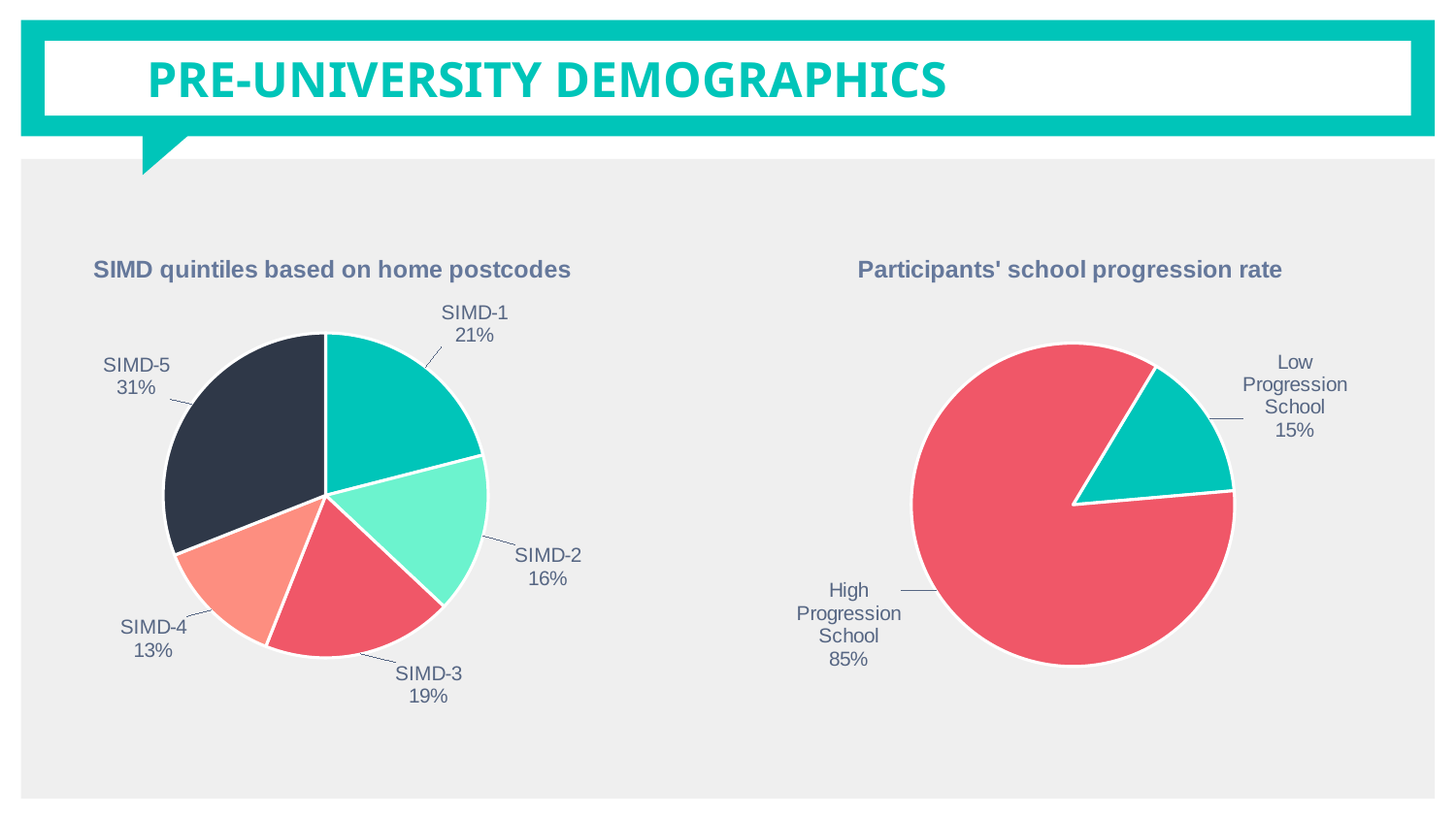
In the 'Participants' school progression rate' chart, what share is Low Progression School? 15% In the 'SIMD quintiles based on home postcodes' chart, which quintile has the smallest share? SIMD-4 In the 'SIMD quintiles based on home postcodes' chart, what share does SIMD-5 have? 31% In the 'SIMD quintiles based on home postcodes' chart, which quintile has the largest share? SIMD-5 In the 'Participants' school progression rate' chart, what is the difference between High Progression School and Low Progression School? 70% How many slices does the 'SIMD quintiles based on home postcodes' chart have? 5 What type of chart is 'Participants' school progression rate'? Pie chart In the 'SIMD quintiles based on home postcodes' chart, which is larger, SIMD-3 or SIMD-2? SIMD-3 In the 'SIMD quintiles based on home postcodes' chart, what is the difference between the SIMD-5 and SIMD-1 shares? 10% In the 'SIMD quintiles based on home postcodes' chart, what share does SIMD-2 have? 16% What is the title of the chart on the left of the slide? SIMD quintiles based on home postcodes How many slices does the 'Participants' school progression rate' chart have? 2